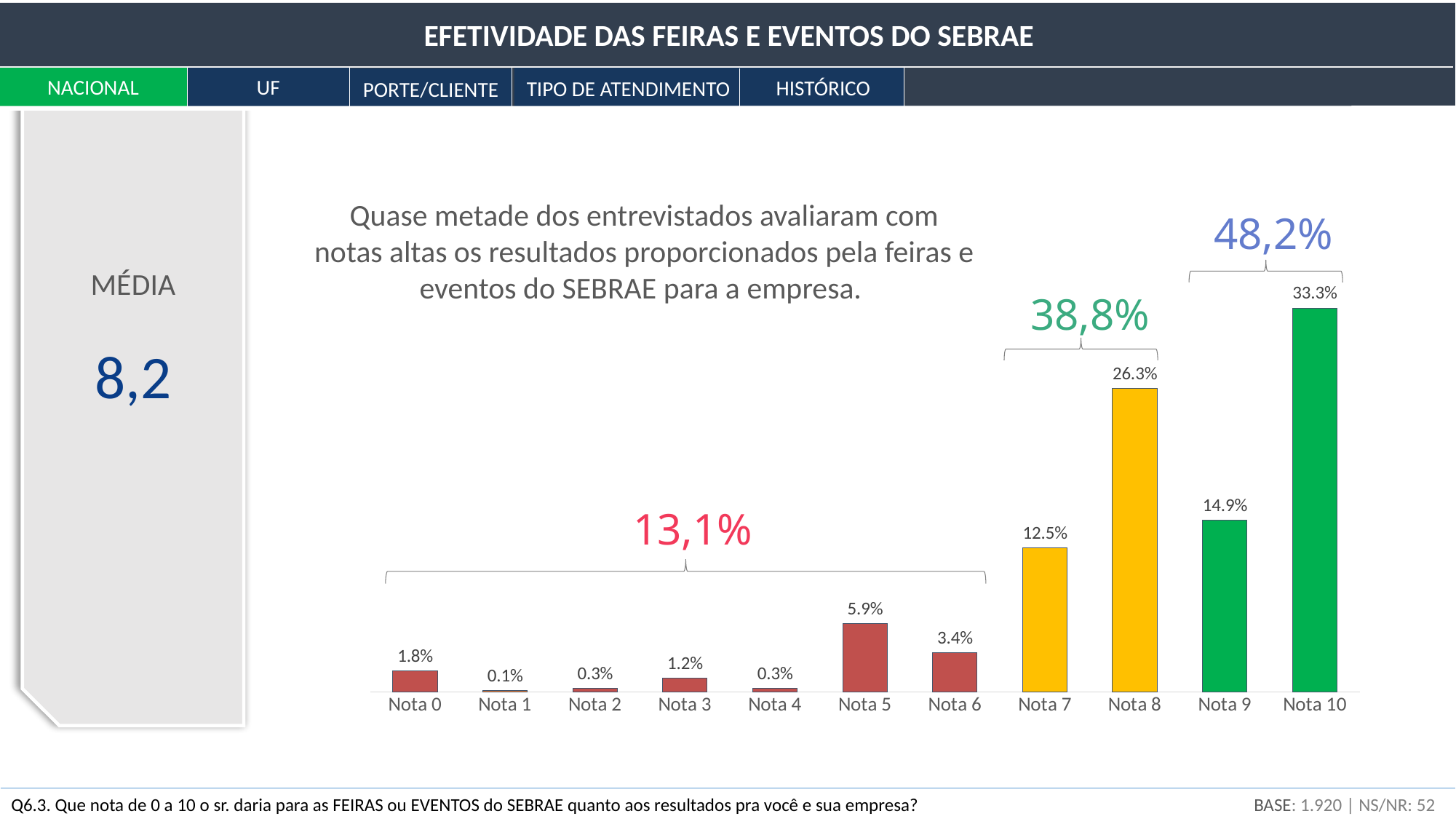
What is the average (MÉDIA) shown on the left of the slide? 8,2 What kind of chart is this? Bar chart What is the value for Nota 5? 5.9% What is the value for Nota 10? 33.3% What is the value for Nota 8? 26.3% What is the combined share shown above the bracket for Nota 9 and Nota 10? 48,2% What is the combined share shown above the bracket for Nota 0 to Nota 6? 13,1% What is the difference between the values for Nota 10 and Nota 8? 7.0% How many categories are shown on the x axis? 11 Which is larger, the value for Nota 7 or the value for Nota 9? Nota 9 Which category has the lowest value? Nota 1 Which category has the highest value? Nota 10